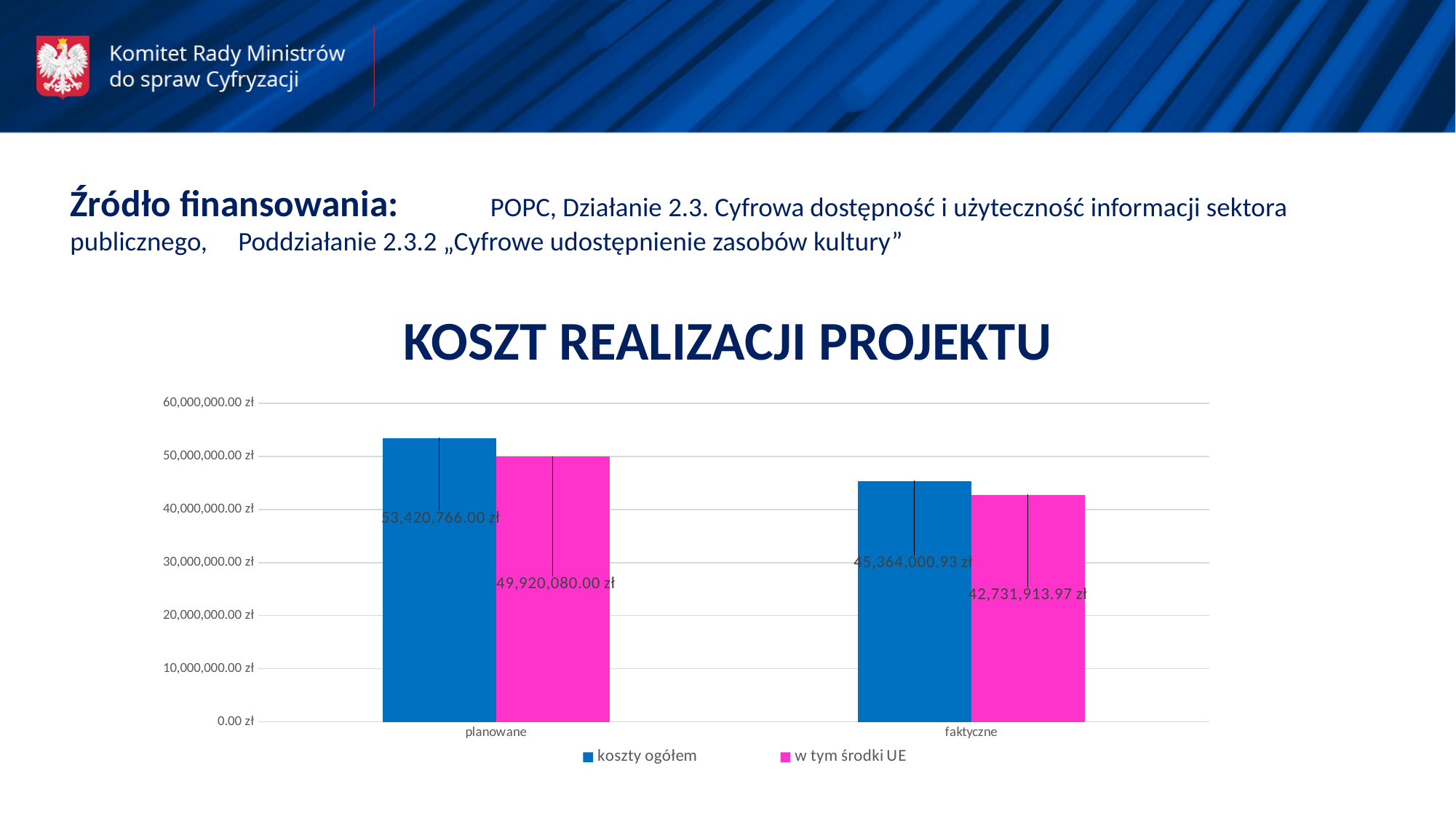
What is the value of 'koszty ogółem' for 'planowane'? 53,420,766.00 zł How many categories are shown on the x axis? 2 Which is larger: 'w tym środki UE' for 'planowane' or 'w tym środki UE' for 'faktyczne'? planowane What is the difference between 'koszty ogółem' and 'w tym środki UE' for 'planowane'? 3,500,686.00 zł What is the value of 'w tym środki UE' for 'faktyczne'? 42,731,913.97 zł What is the difference between 'koszty ogółem' for 'planowane' and for 'faktyczne'? 8,056,765.07 zł How many series does the legend list? 2 What is the title of the chart? KOSZT REALIZACJI PROJEKTU Which category has the highest 'koszty ogółem' value? planowane What is the value of 'koszty ogółem' for 'faktyczne'? 45,364,000.93 zł What type of chart is shown on the slide? bar chart What is the value of 'w tym środki UE' for 'planowane'? 49,920,080.00 zł